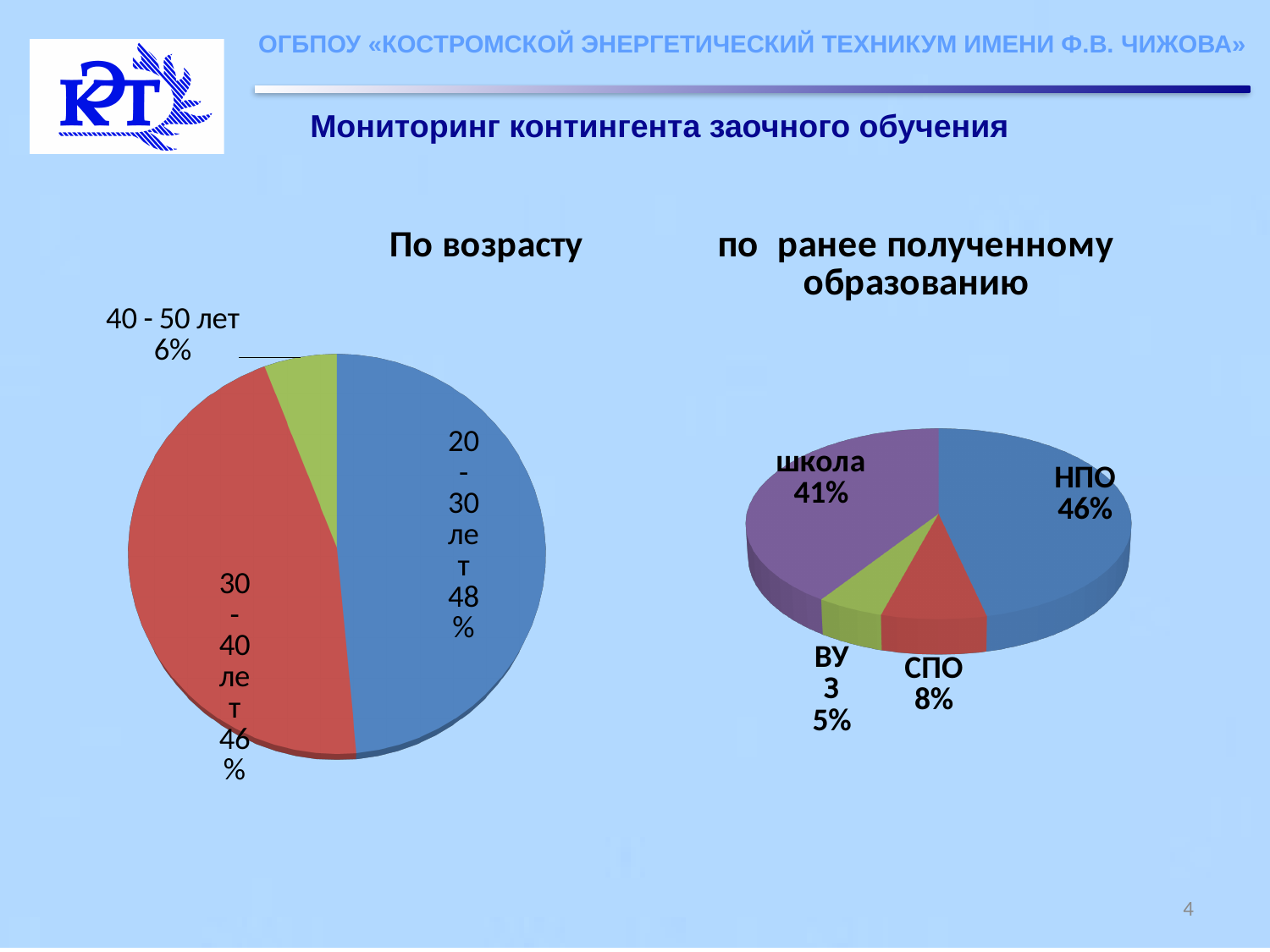
In the 'по ранее полученному образованию' chart, how many categories are shown? 4 In the 'по ранее полученному образованию' chart, which is larger: школа or НПО? НПО In the 'по ранее полученному образованию' chart, what share is shown for НПО? 46% In the 'По возрасту' chart, which age group has the smallest share? 40 - 50 лет In the 'По возрасту' chart, what share is shown for the 20 - 30 лет slice? 48% In the 'по ранее полученному образованию' chart, what share is shown for СПО? 8% In the 'По возрасту' chart, how many slices does the pie have? 3 In the 'По возрасту' chart, what share is shown for the 40 - 50 лет slice? 6% In the 'По возрасту' chart, which age group has the largest share? 20 - 30 лет What type of chart is used for 'По возрасту'? Pie chart In the 'по ранее полученному образованию' chart, which category has the smallest share? ВУЗ In the 'По возрасту' chart, what is the difference between the 30 - 40 лет share and the 40 - 50 лет share? 40%